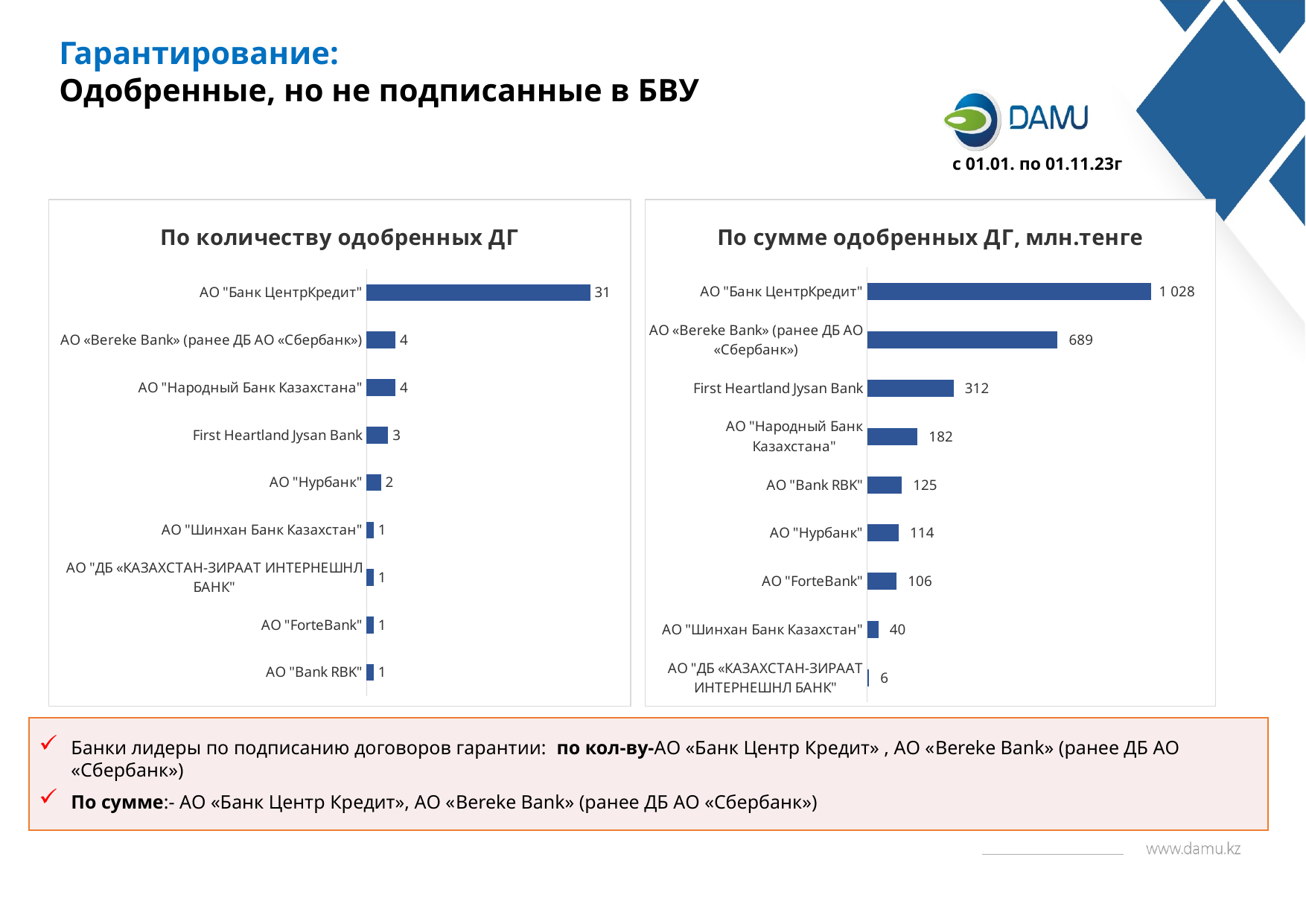
What is the title of the chart on the left side of the slide? По количеству одобренных ДГ In the chart "По количеству одобренных ДГ", what is the value for First Heartland Jysan Bank? 3 In the chart "По количеству одобренных ДГ", what is the value for АО "Банк ЦентрКредит"? 31 In the chart "По сумме одобренных ДГ, млн.тенге", which is larger: АО "Нурбанк" or АО "ForteBank"? АО "Нурбанк" In the chart "По сумме одобренных ДГ, млн.тенге", what is the value for АО «Bereke Bank» (ранее ДБ АО «Сбербанк»)? 689 In the chart "По количеству одобренных ДГ", what is the difference between АО "Банк ЦентрКредит" and АО «Bereke Bank» (ранее ДБ АО «Сбербанк»)? 27 In the chart "По сумме одобренных ДГ, млн.тенге", what is the difference between First Heartland Jysan Bank and АО "Народный Банк Казахстана"? 130 In the chart "По количеству одобренных ДГ", which bank has the highest value? АО "Банк ЦентрКредит" What type of chart is "По сумме одобренных ДГ, млн.тенге"? Bar chart In the chart "По сумме одобренных ДГ, млн.тенге", which bank has the lowest value? АО "ДБ «КАЗАХСТАН-ЗИРААТ ИНТЕРНЕШНЛ БАНК" In the chart "По сумме одобренных ДГ, млн.тенге", what is the value for АО "Bank RBK"? 125 In the chart "По количеству одобренных ДГ", how many banks are listed? 9